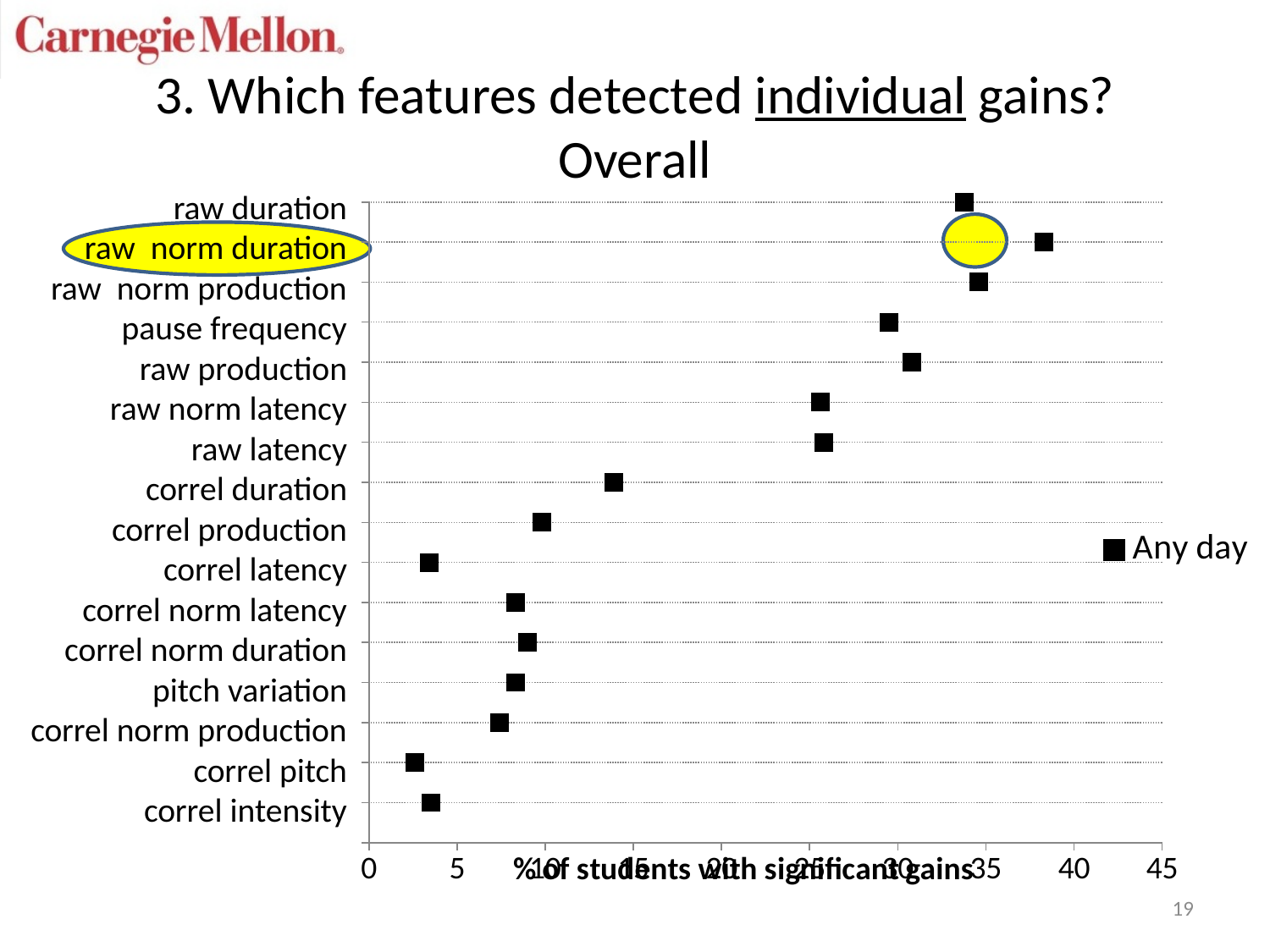
Is the value for raw norm duration greater or less than 35? greater Which feature has the highest % of students with significant gains? raw norm duration Is the value for correl pitch greater or less than 5? less Which has a larger value, raw duration or correl duration? raw duration What kind of chart is shown on the slide? scatter chart Is the value for correl duration greater or less than 20? less How many series does the chart legend list? 1 What is the label of the horizontal axis of the chart? % of students with significant gains How many features (categories) are listed on the vertical axis of the chart? 16 What is the name of the series shown in the chart legend? Any day